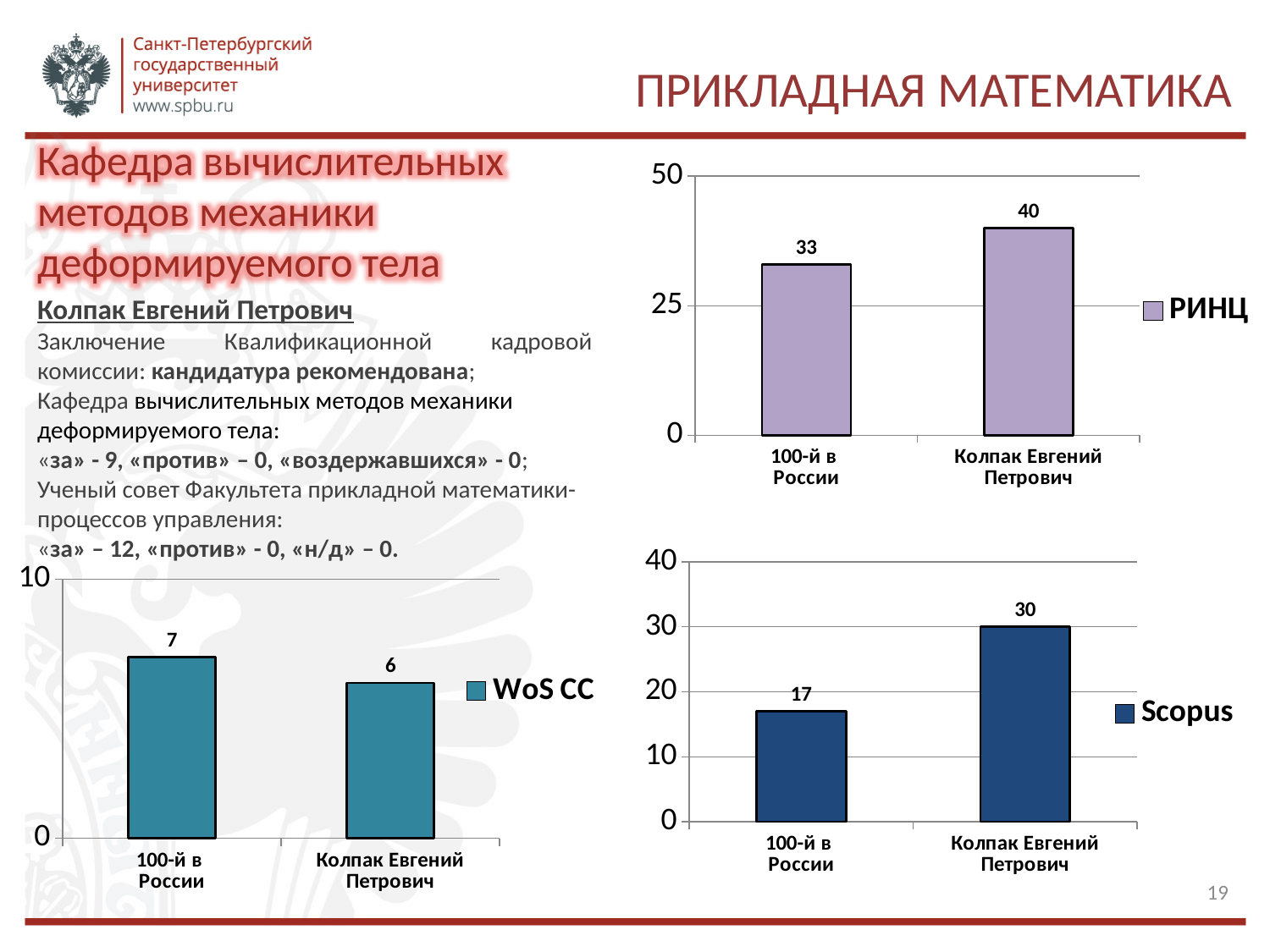
How many categories are shown in the Scopus chart (bottom right)? 2 In the РИНЦ chart (top right), what is the value for 100-й в России? 33 In the РИНЦ chart (top right), what is the difference between the values for Колпак Евгений Петрович and 100-й в России? 7 In the WoS CC chart (bottom left), what is the value for Колпак Евгений Петрович? 6 What kind of chart is the РИНЦ chart (top right)? Bar chart In the Scopus chart (bottom right), what is the value for 100-й в России? 17 In the WoS CC chart (bottom left), which category has the lowest value? Колпак Евгений Петрович In the РИНЦ chart (top right), what is the value for Колпак Евгений Петрович? 40 In the WoS CC chart (bottom left), which is larger: the value for 100-й в России or for Колпак Евгений Петрович? 100-й в России In the Scopus chart (bottom right), what is the difference between the values for Колпак Евгений Петрович and 100-й в России? 13 What series name does the legend of the bottom-left chart show? WoS CC In the Scopus chart (bottom right), which category has the highest value? Колпак Евгений Петрович